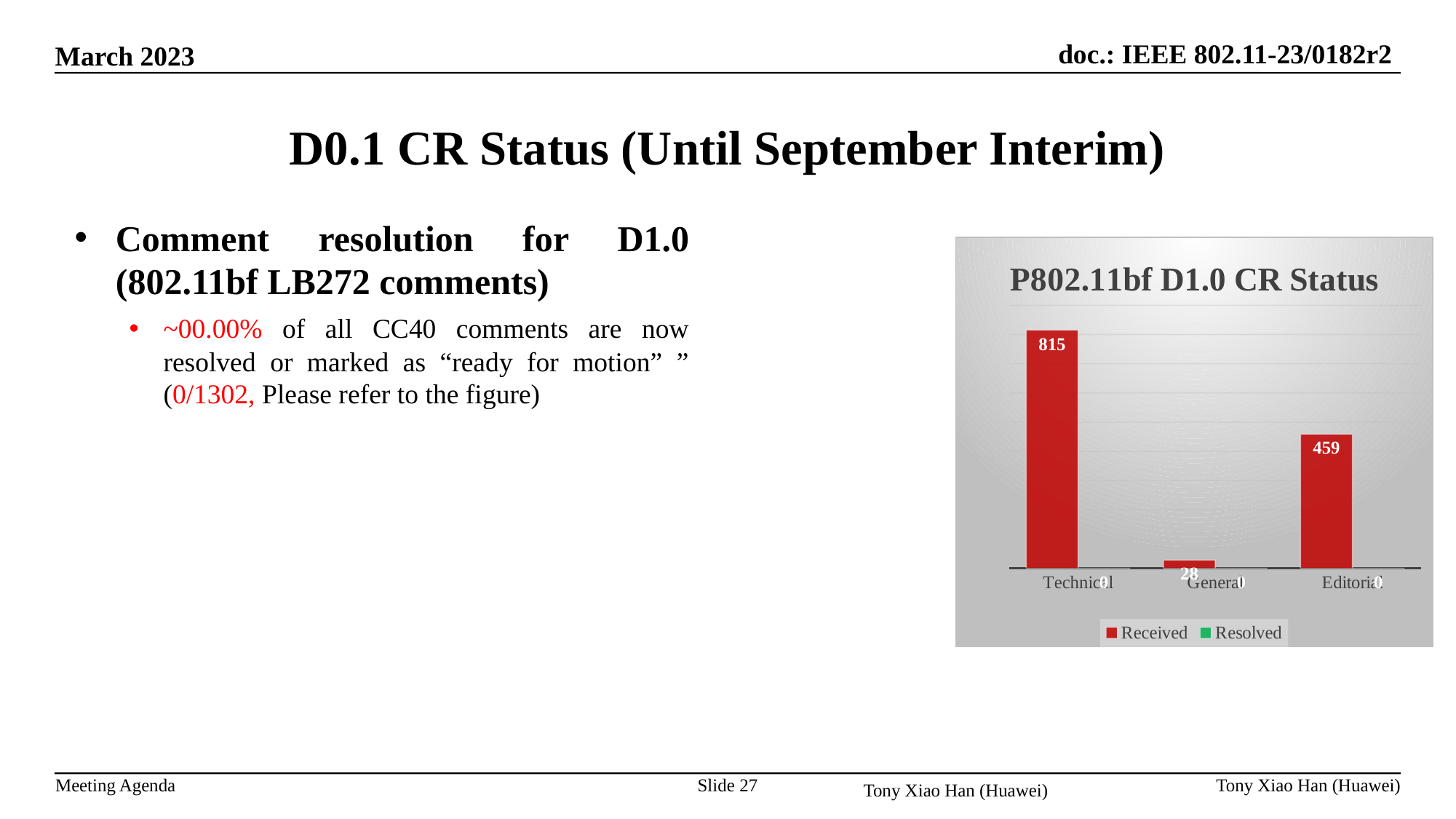
Which category has the highest Received value? Technical What is the Received value for General? 28 How many series does the legend list? 2 What is the Received value for Editorial? 459 What kind of chart is shown? Bar chart How many categories are shown on the x axis? 3 What is the title of the chart? P802.11bf D1.0 CR Status What is the difference between the Received values for Editorial and General? 431 What is the Received value for Technical? 815 Which is larger, the Received value for Technical or for Editorial? Technical What is the difference between the Received values for Technical and Editorial? 356 Which category has the lowest Received value? General